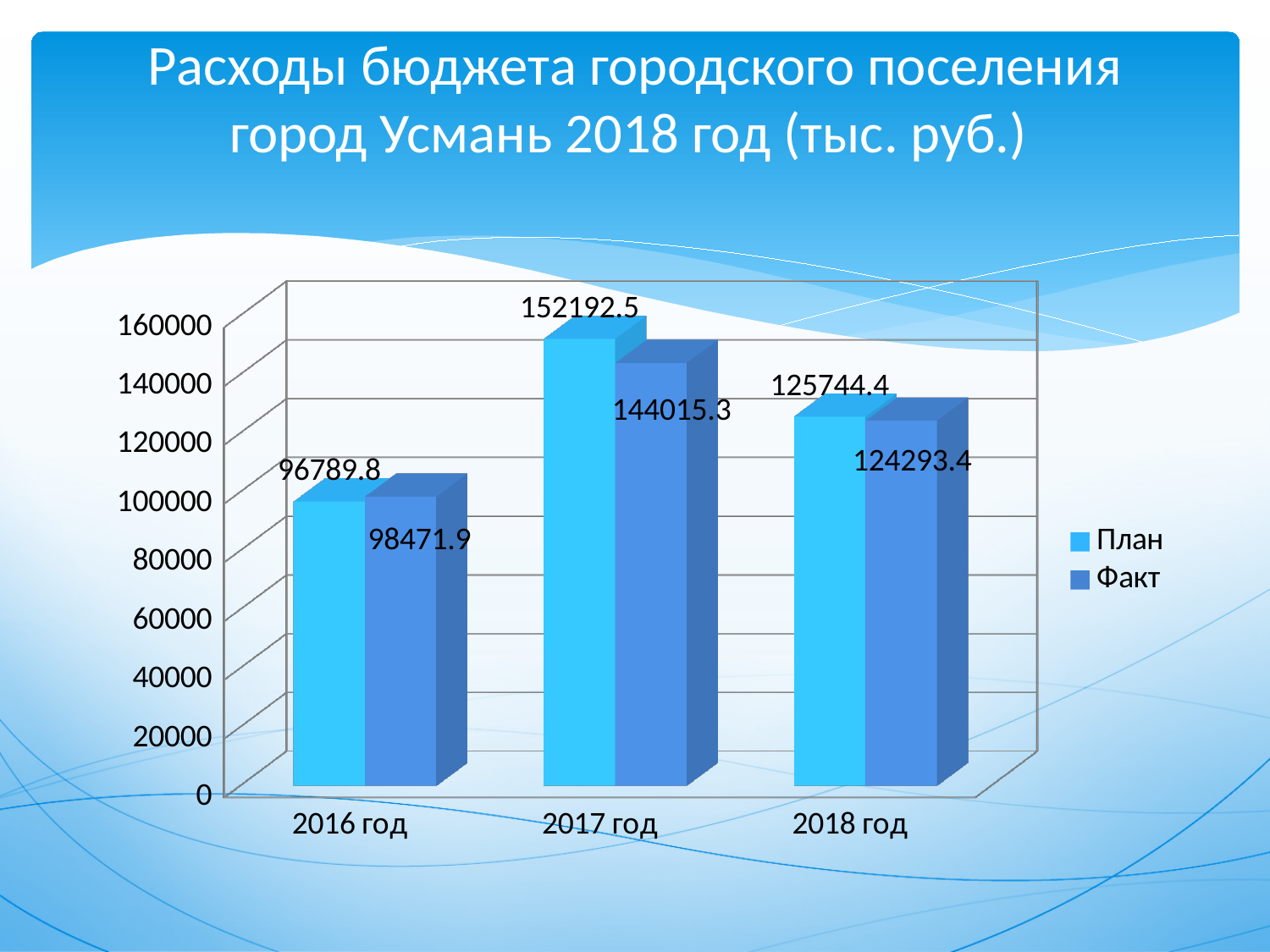
What is the Факт value for 2016 год? 98471.9 What is the difference between the Факт and План values for 2016 год? 1682.1 Which year has the lowest Факт value? 2016 год Which is larger for 2017 год, План or Факт? План Which year has the highest План value? 2017 год How many years are shown on the x axis? 3 How many series does the legend list? 2 What kind of chart is shown on the slide? bar chart What is the Факт value for 2018 год? 124293.4 What is the План value for 2017 год? 152192.5 Is the План value for 2018 год greater or less than 120000? greater What is the difference between the План and Факт values for 2017 год? 8177.2